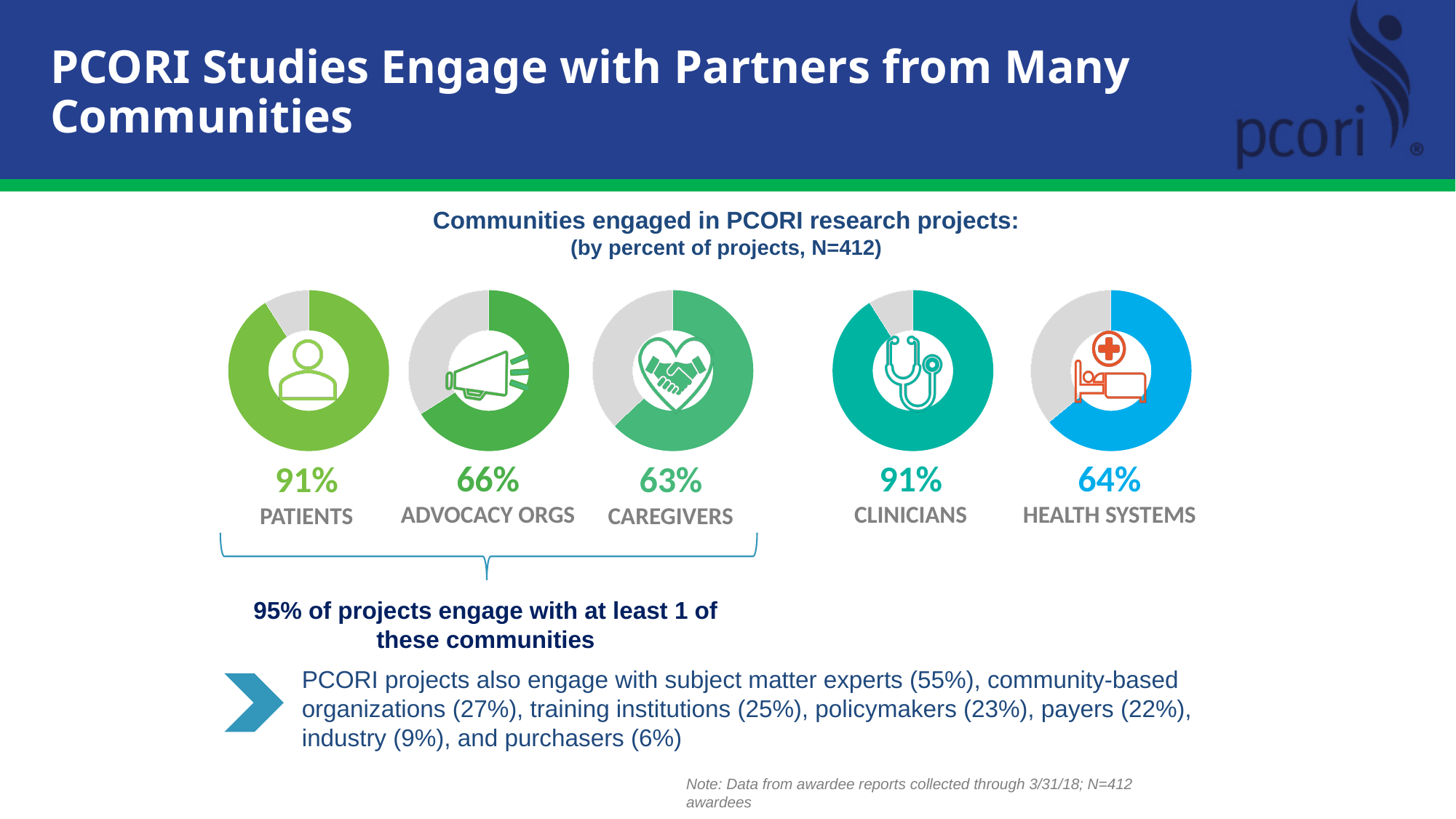
What percentage of projects engage with patients, according to the Patients donut chart? 91% What kind of chart is used to show the community engagement percentages? Donut chart What value is shown for the Clinicians donut chart? 91% What percentage is shown for the Health Systems donut chart? 64% What is the N value stated in the subtitle above the donut charts? N=412 What is the difference between the Advocacy Orgs percentage and the Health Systems percentage? 2% What value is shown for the Advocacy Orgs donut chart? 66% Which is larger, the Advocacy Orgs percentage or the Health Systems percentage? Advocacy Orgs What is the difference between the Patients percentage and the Caregivers percentage? 28% Which community has the lowest engagement percentage among the five donut charts? Caregivers How many donut charts are shown on the slide? 5 What percentage is shown for the Caregivers donut chart? 63%